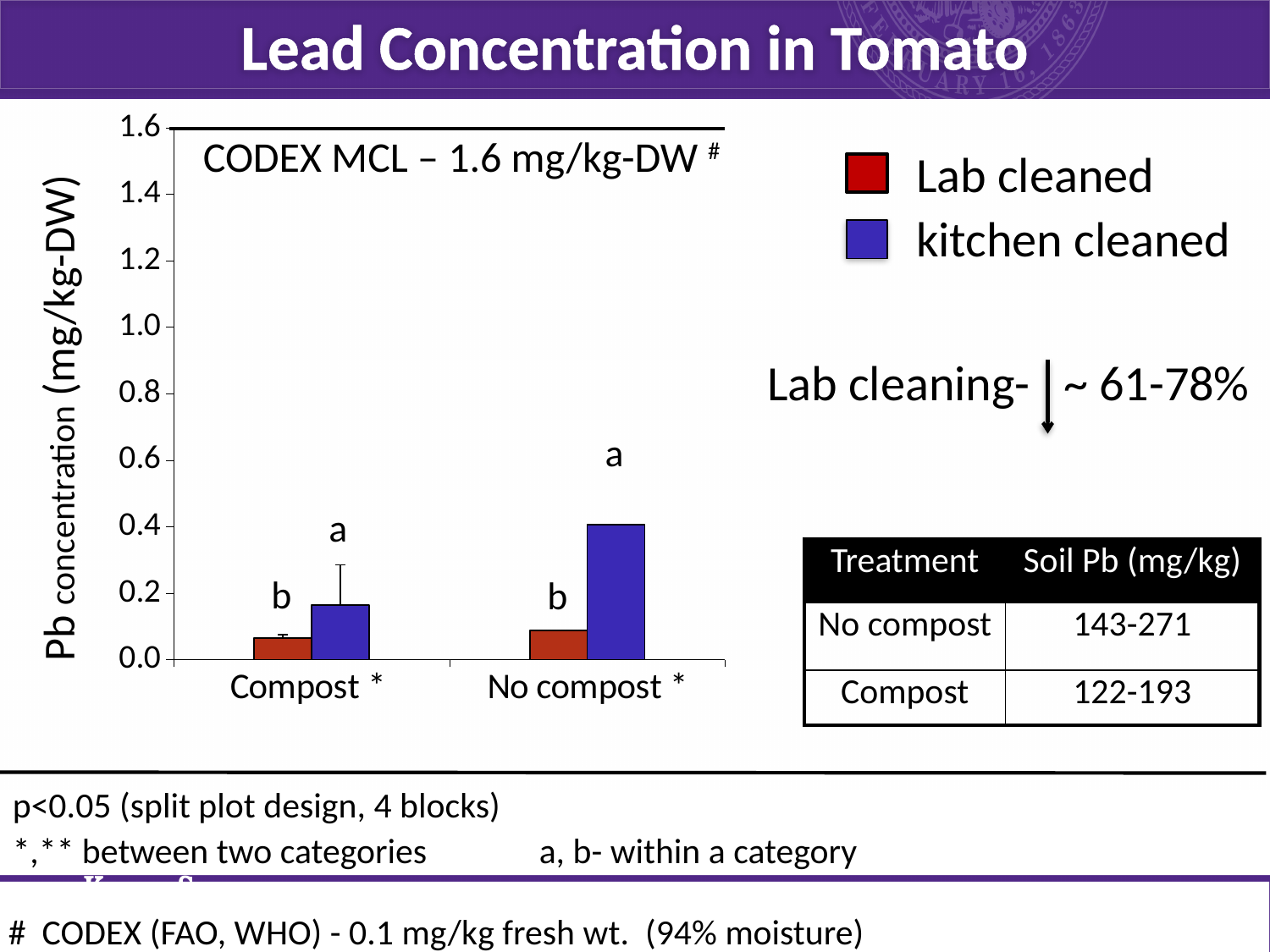
For the kitchen cleaned series, which category has the lower value, Compost or No compost? Compost What kind of chart is shown on the slide? bar chart For the Lab cleaned series, is the value for Compost greater or less than 0.2? less Which bar is the highest in the chart? kitchen cleaned, No compost What is the title of the chart? Lead Concentration in Tomato For the Lab cleaned series, is the value for No compost greater or less than 0.2? less For the kitchen cleaned series, is the value for No compost greater or less than 0.2? greater Which series is shown in blue in the legend? kitchen cleaned In the No compost category, which is larger, the Lab cleaned value or the kitchen cleaned value? kitchen cleaned How many categories are shown on the x axis? 2 How many series does the legend list? 2